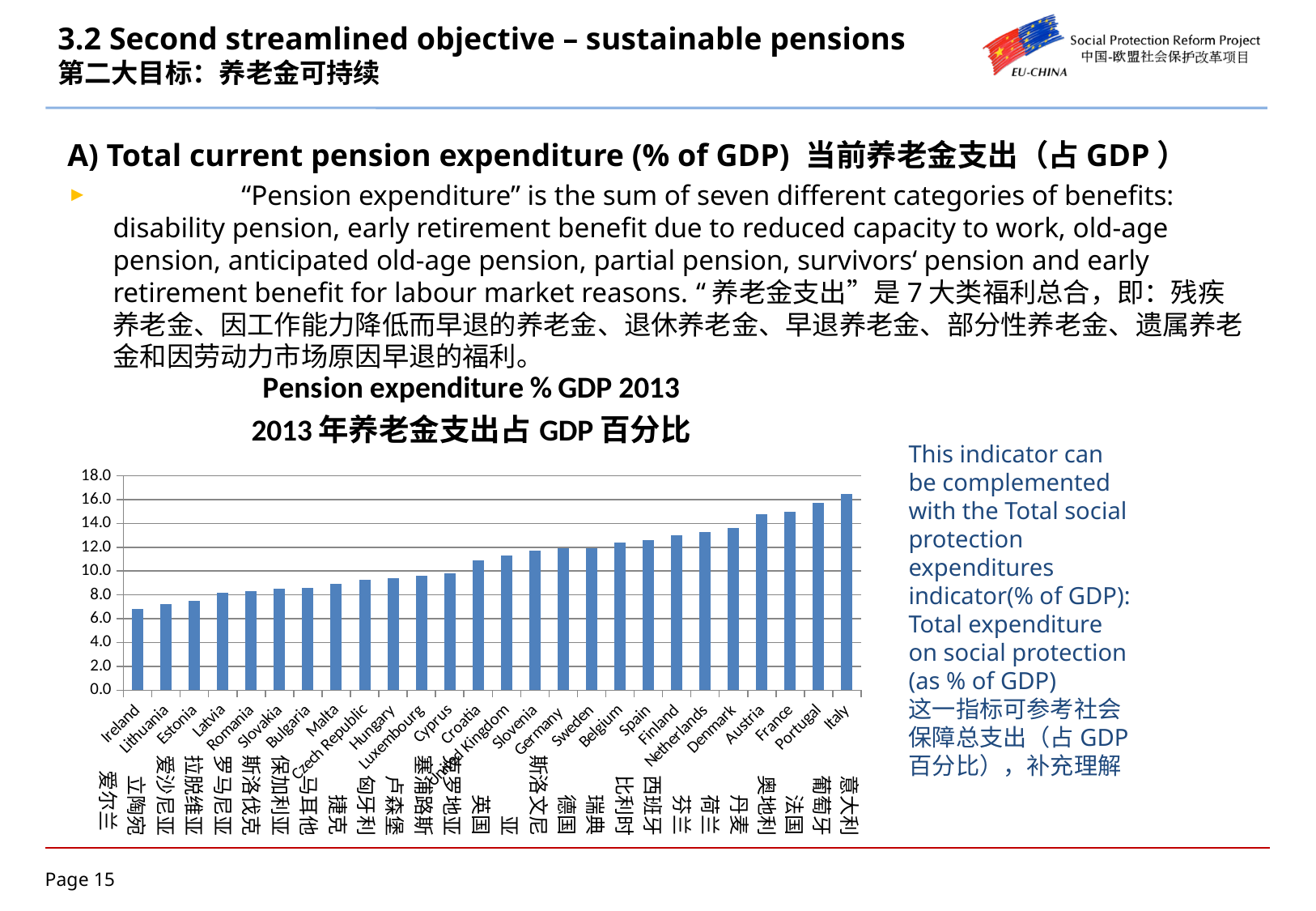
Do the values rise or fall moving from left to right along the x axis? rise What kind of chart is shown on the slide? bar chart Which has the larger value, France or Spain? France How many countries are shown in the chart? 26 Is the value for Malta greater or less than 10.0? less Is the value for Italy greater or less than 14.0? greater What is the English title of the chart? Pension expenditure % GDP 2013 Which country has the highest pension expenditure as % of GDP in the chart? Italy Is the value for Ireland greater or less than 8.0? less Which country has the lowest pension expenditure as % of GDP in the chart? Ireland